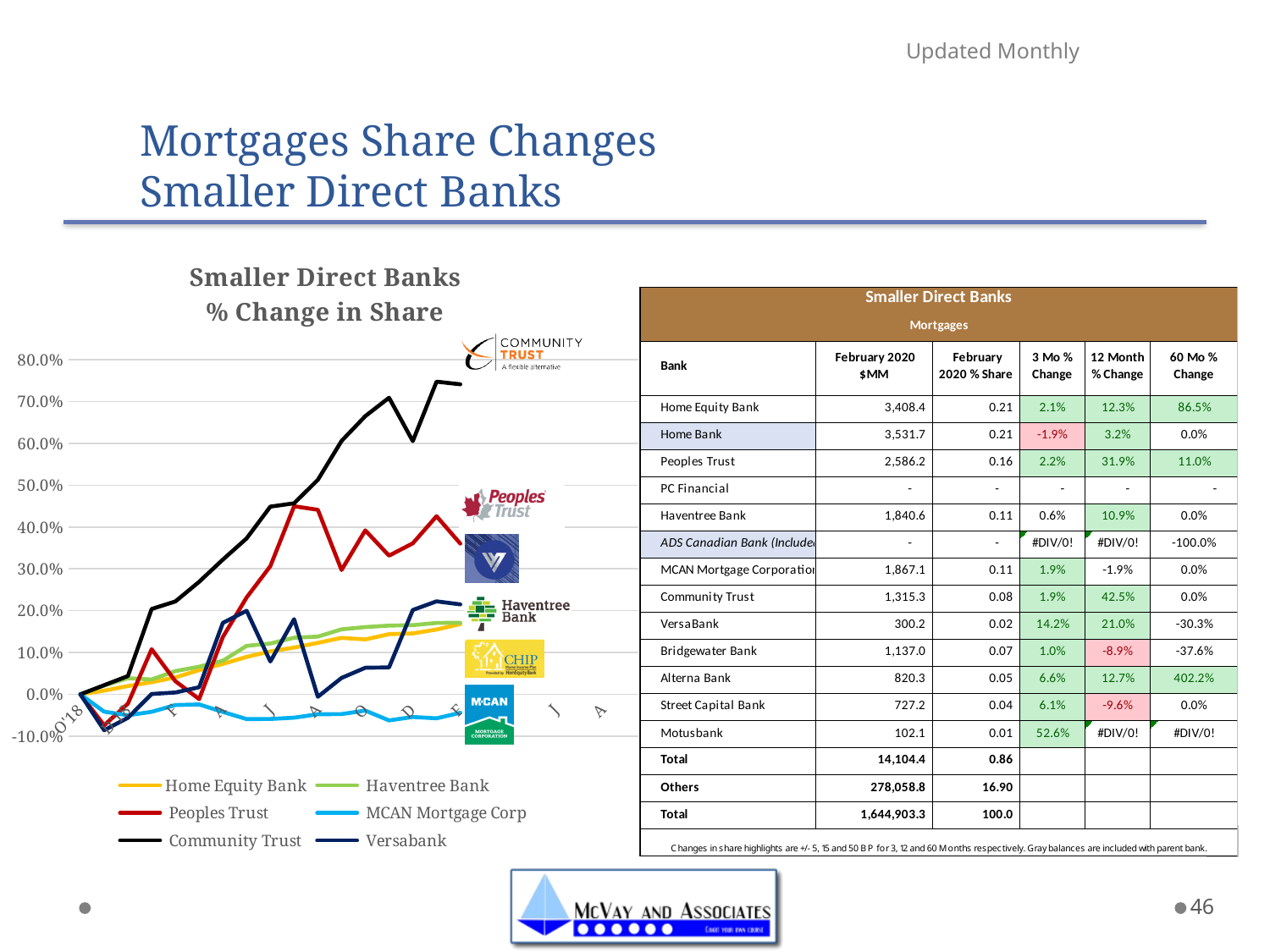
Does the Community Trust line generally rise or fall from left to right across the chart? rise At the right end of the chart, is the value for Peoples Trust greater or less than 30.0%? greater What is the title of the chart on the left of the slide? Smaller Direct Banks % Change in Share At the right end of the chart, which is larger: the value for Community Trust or the value for Peoples Trust? Community Trust At the right end of the chart, is the value for MCAN Mortgage Corp greater or less than 0.0%? less Which series has the lowest value at the right end of the chart? MCAN Mortgage Corp At the right end of the chart, is the value for Versabank greater or less than 10.0%? greater How many series does the legend of the chart list? 6 What kind of chart is shown on the slide? line chart Which series has the highest value at the right end of the chart? Community Trust Which colour is used for the Community Trust line in the chart? black